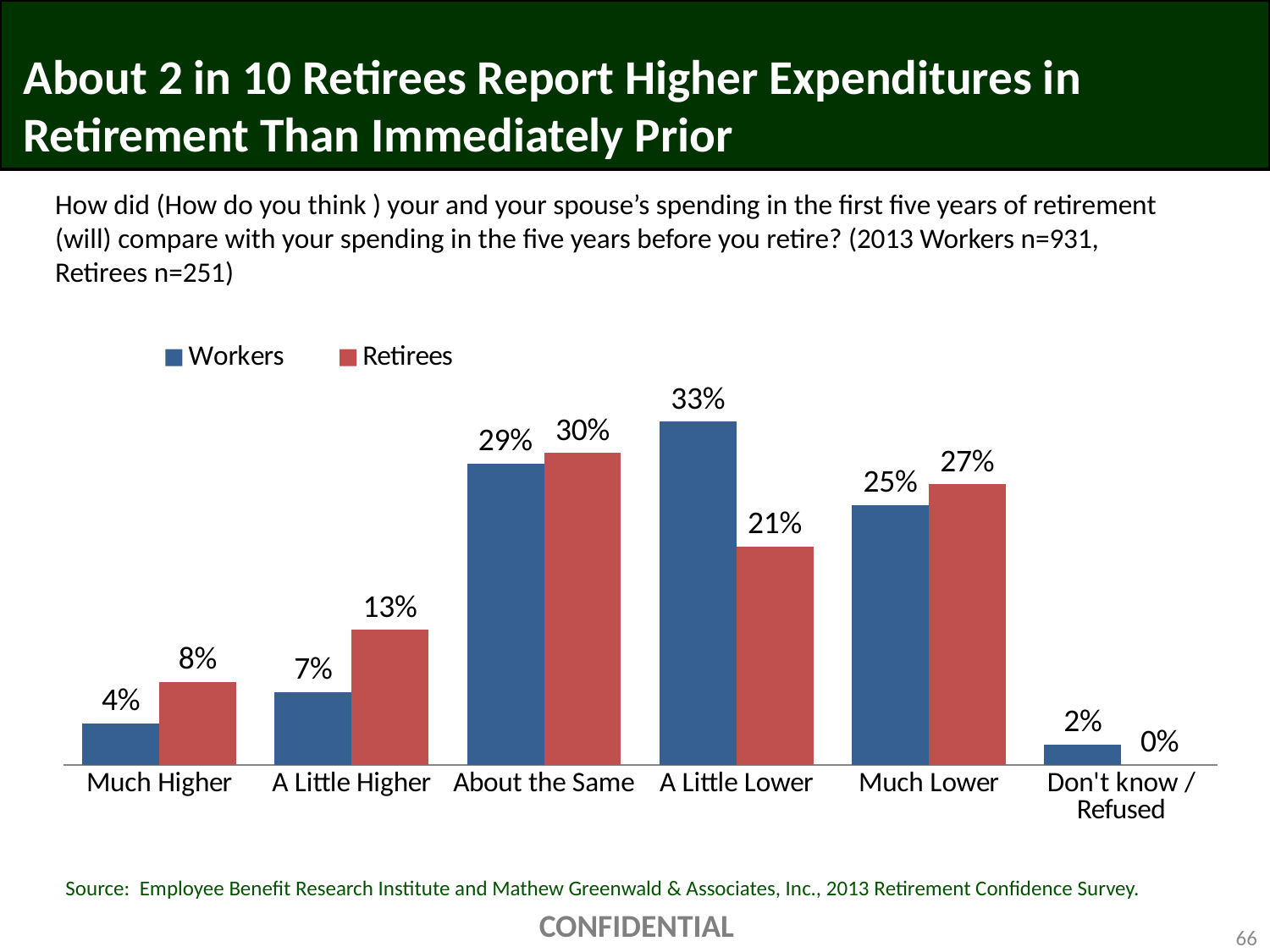
What percentage of Retirees reported spending "A Little Higher"? 13% Which category has the lowest value for Retirees? Don't know / Refused In the "Much Lower" category, which series has the larger value, Workers or Retirees? Retirees What percentage of Workers said their spending would be "Much Higher"? 4% How many series does the legend list? 2 What is the difference between Workers and Retirees in the "A Little Lower" category? 12 percentage points What is the value for Retirees in the "A Little Lower" category? 21% How many response categories are shown on the x axis? 6 What is the total of the Workers and Retirees values for "About the Same"? 59% What kind of chart is shown on the slide? Bar chart Which category has the highest value for Workers? A Little Lower Which colour represents the Retirees series in the chart? Red